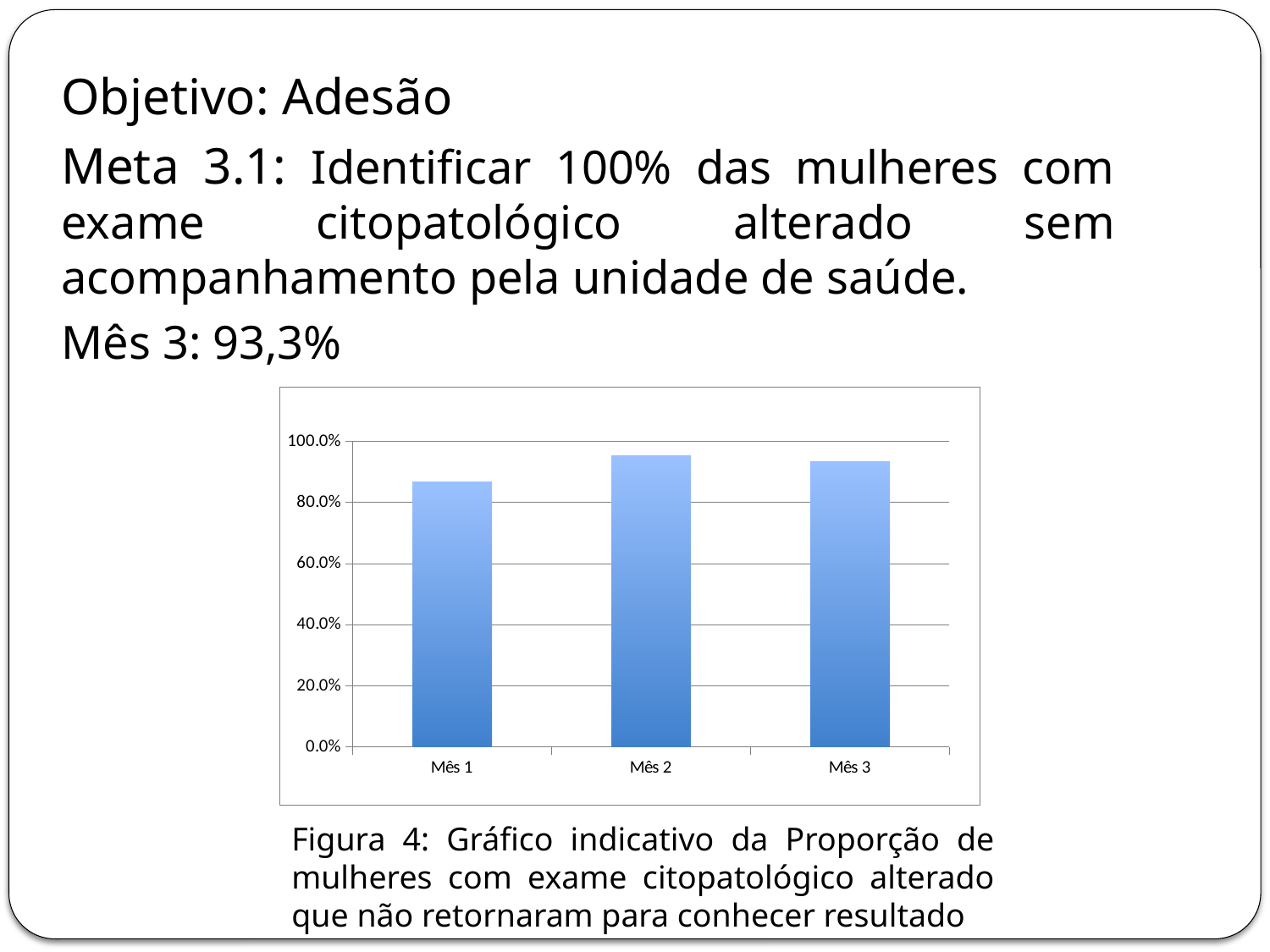
How many months (categories) are plotted in the chart? 3 Is the value for Mês 1 greater or less than 80.0%? greater What kind of chart is shown on the slide? bar chart Which month has the highest value in the chart? Mês 2 Which is larger, the value for Mês 1 or the value for Mês 2? Mês 2 What is the highest tick shown on the vertical axis of the chart? 100.0% Is the value for Mês 2 greater or less than 100.0%? less Is the value for Mês 3 greater or less than 80.0%? greater What figure number is given in the caption below the chart? Figura 4 Which month has the lowest value in the chart? Mês 1 Does the value rise or fall from Mês 1 to Mês 2? rise What is the value for Mês 3 according to the slide? 93,3%